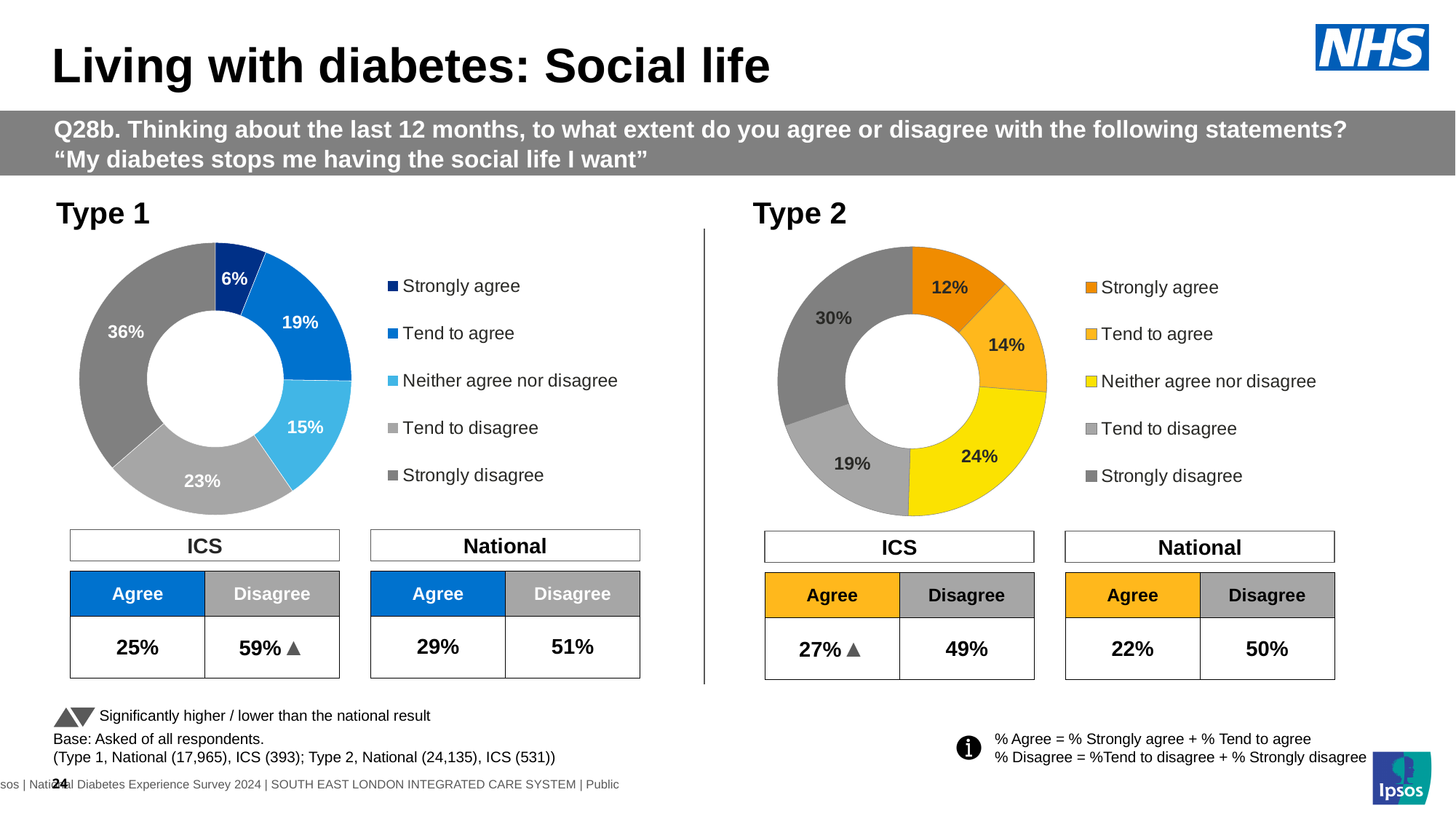
In the Type 2 chart, what percentage of respondents neither agree nor disagree? 24% In the Type 2 chart, which category has the smallest share? Strongly agree In the Type 1 chart, what is the difference between the Strongly disagree and Tend to disagree shares? 13% In the Type 1 chart, which category has the largest share? Strongly disagree In the Type 1 chart, what percentage of respondents strongly agree? 6% In the Type 1 chart, what is the share of the Tend to agree slice? 19% In the Type 1 chart, what percentage of respondents tend to disagree? 23% What kind of chart is used for Type 2? Doughnut chart In the Type 2 chart, which is larger: Tend to agree or Tend to disagree? Tend to disagree In the Type 2 chart, what is the combined share of Strongly agree and Tend to agree? 26% In the Type 2 chart, what colour is the Neither agree nor disagree slice? Yellow How many categories does the Type 1 chart show? 5